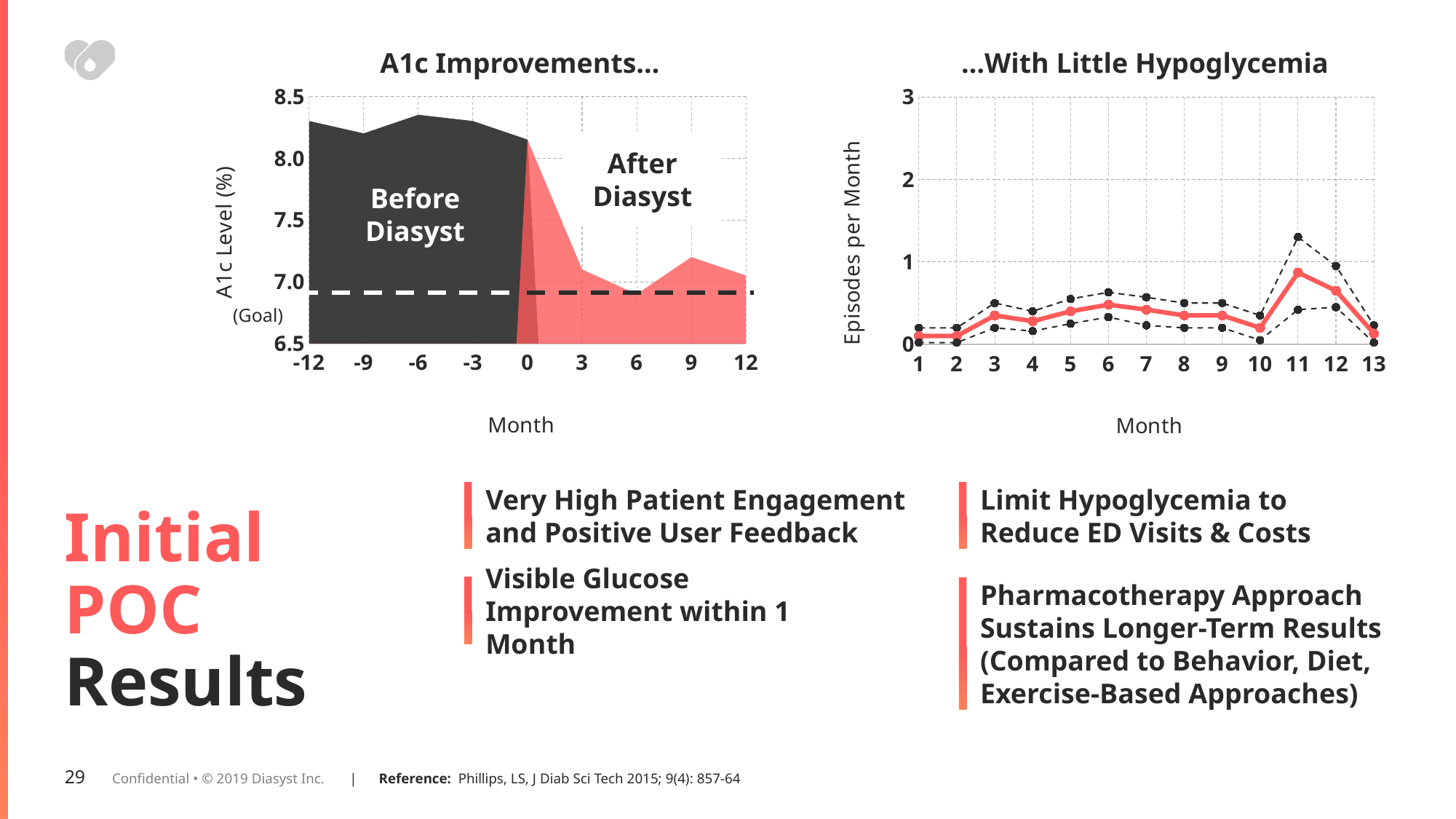
What is the y-axis title of the "...With Little Hypoglycemia" chart? Episodes per Month In the "A1c Improvements..." chart, do the values rise or fall from month 0 to month 6? fall In the "...With Little Hypoglycemia" chart, is the solid line value at month 13 greater or less than 0.5? less In the "...With Little Hypoglycemia" chart, is the solid line value at month 11 greater or less than 0.5? greater In the "A1c Improvements..." chart, which is larger: the value at month -3 or the value at month 3? month -3 What kind of chart is the "A1c Improvements..." chart on the left? area chart What is the y-axis title of the "A1c Improvements..." chart? A1c Level (%) What kind of chart is the "...With Little Hypoglycemia" chart on the right? line chart In the "A1c Improvements..." chart, is the value at month 6 greater or less than 7.5? less In the "...With Little Hypoglycemia" chart, how many months are labelled on the x axis? 13 In the "...With Little Hypoglycemia" chart, which month has the highest value on the solid line? 11